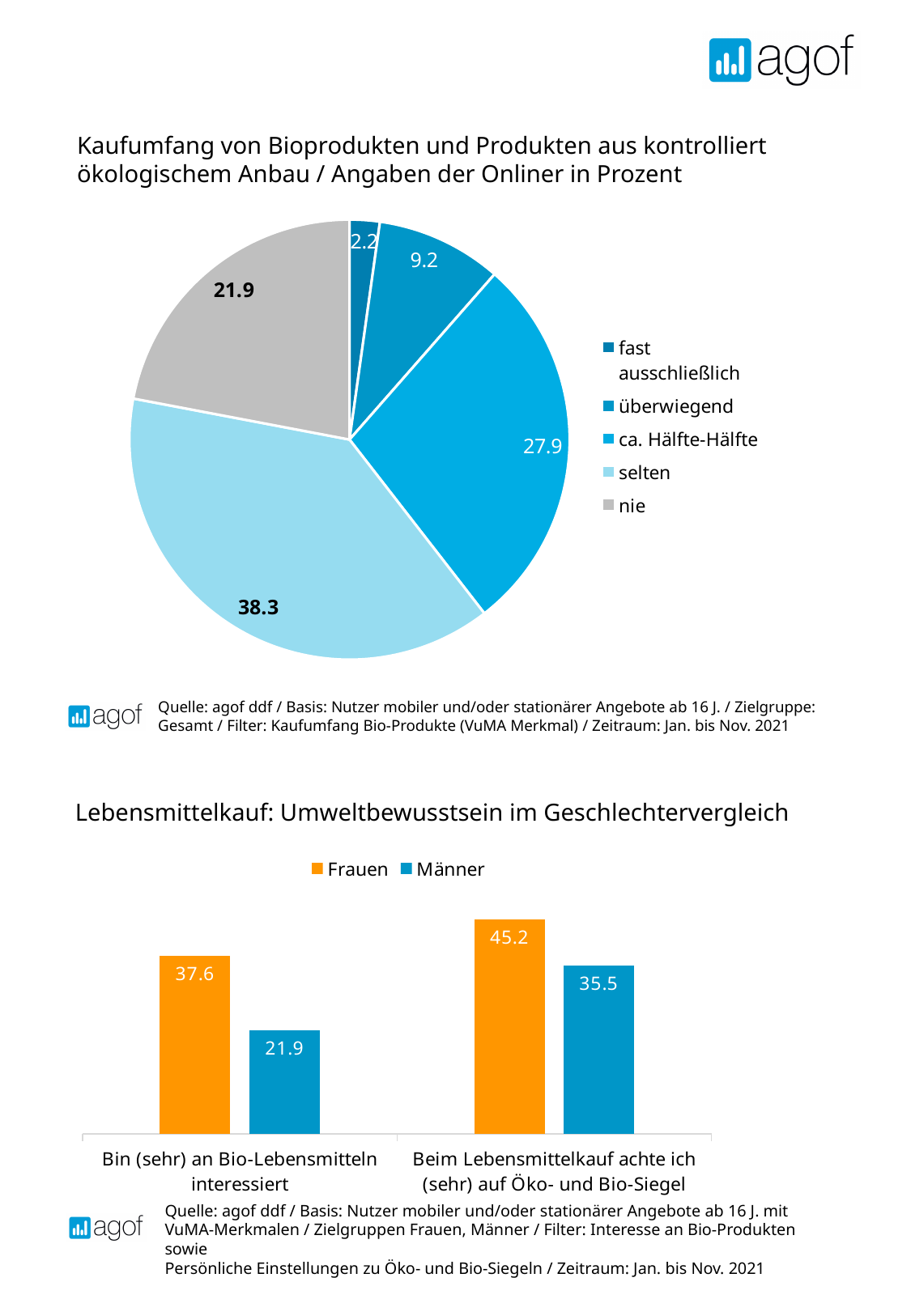
In the top pie chart (Kaufumfang von Bioprodukten), how many categories does the legend list? 5 In the top pie chart (Kaufumfang von Bioprodukten), which category has the smallest slice? fast ausschließlich What kind of chart is the top chart (Kaufumfang von Bioprodukten)? pie chart In the bottom bar chart (Lebensmittelkauf: Umweltbewusstsein im Geschlechtervergleich), what is the value for Frauen for "Beim Lebensmittelkauf achte ich (sehr) auf Öko- und Bio-Siegel"? 45.2 In the top pie chart (Kaufumfang von Bioprodukten), what is the value for "selten"? 38.3 In the bottom bar chart (Lebensmittelkauf: Umweltbewusstsein im Geschlechtervergleich), what is the value for Männer for "Bin (sehr) an Bio-Lebensmitteln interessiert"? 21.9 In the top pie chart (Kaufumfang von Bioprodukten), what is the difference between "ca. Hälfte-Hälfte" and "überwiegend"? 18.7 In the bottom bar chart (Lebensmittelkauf: Umweltbewusstsein im Geschlechtervergleich), how many series does the legend list? 2 In the bottom bar chart (Lebensmittelkauf: Umweltbewusstsein im Geschlechtervergleich), which is larger for "Beim Lebensmittelkauf achte ich (sehr) auf Öko- und Bio-Siegel": Frauen or Männer? Frauen In the top pie chart (Kaufumfang von Bioprodukten), what is the value for "nie"? 21.9 In the bottom bar chart (Lebensmittelkauf: Umweltbewusstsein im Geschlechtervergleich), what is the difference between Frauen and Männer for "Bin (sehr) an Bio-Lebensmitteln interessiert"? 15.7 In the top pie chart (Kaufumfang von Bioprodukten), which category has the largest slice? selten